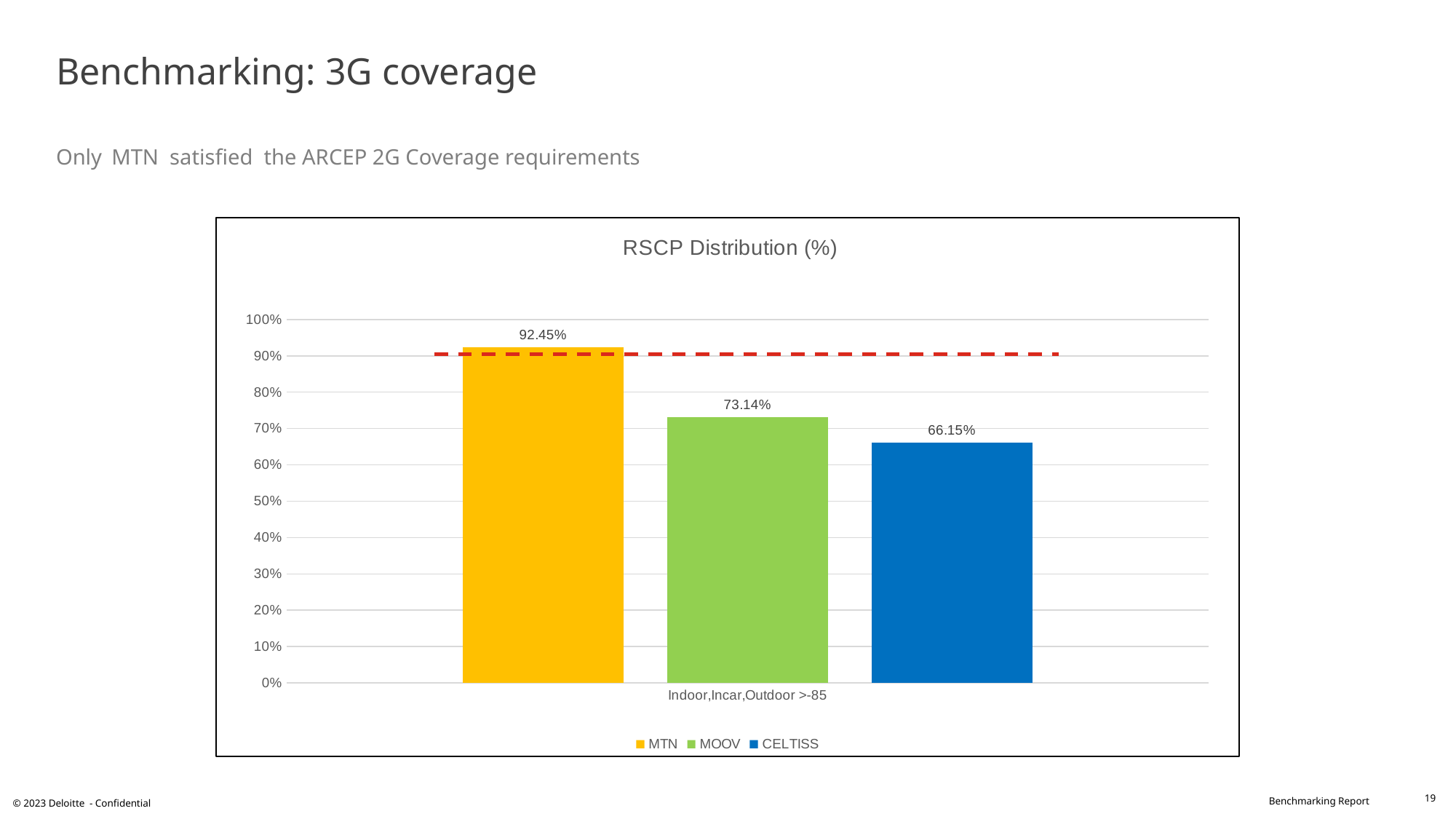
What is the difference between the MTN and MOOV values? 19.31% What is the RSCP distribution value for MOOV? 73.14% Which operator has the highest RSCP distribution value? MTN How many series does the legend list? 3 What kind of chart is shown on the slide? Bar chart What is the title of the chart? RSCP Distribution (%) What is the RSCP distribution value for MTN? 92.45% What is the RSCP distribution value for CELTISS? 66.15% Which operator has the lowest RSCP distribution value? CELTISS Which is larger, the value for MOOV or the value for CELTISS? MOOV Is the value for MTN greater or less than 90%? greater What is the difference between the MOOV and CELTISS values? 6.99%